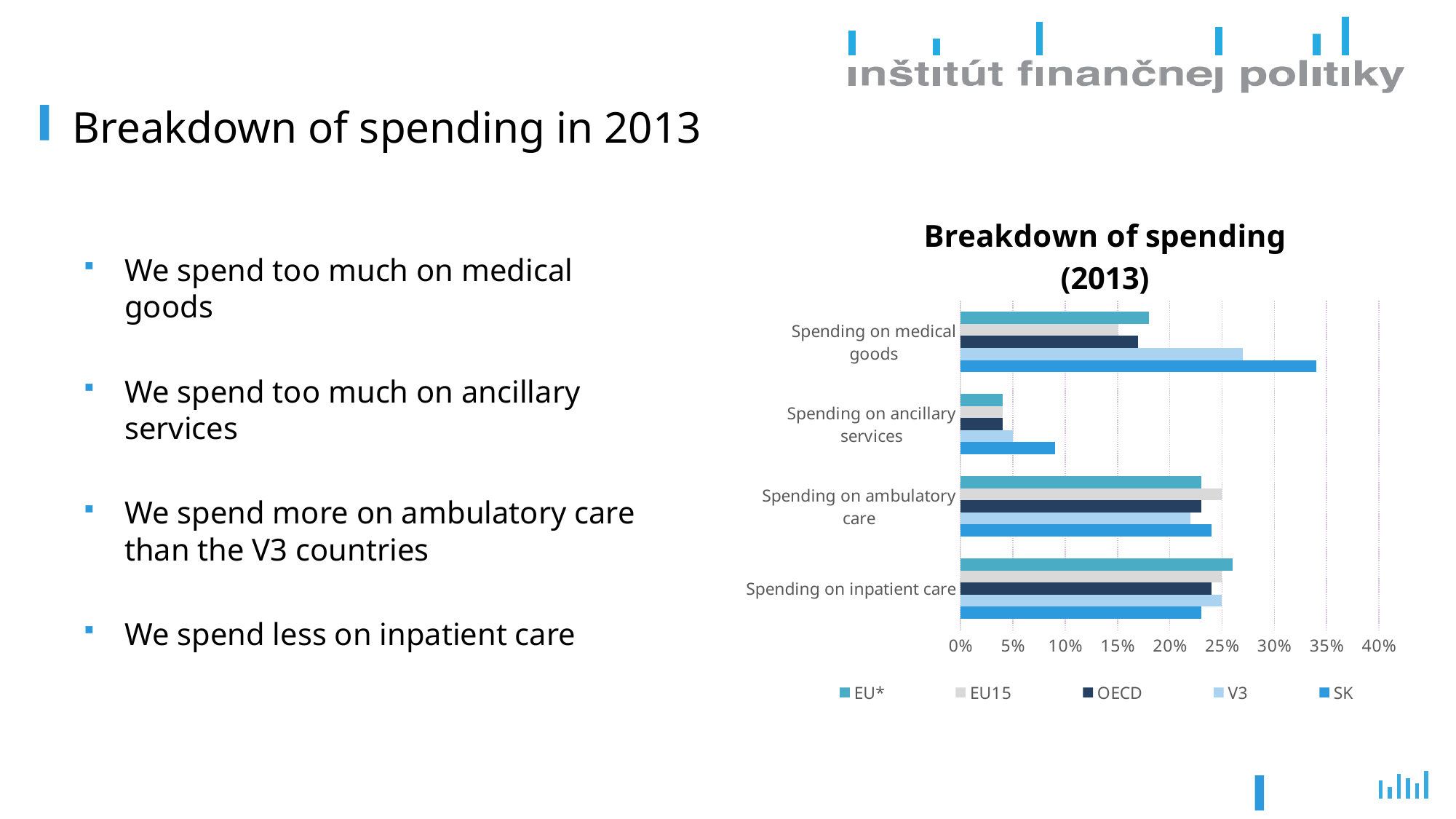
For Spending on medical goods, which is larger: the SK value or the OECD value? SK For Spending on ambulatory care, which is larger: the SK value or the V3 value? SK Which series has the highest value for Spending on medical goods? SK Is the SK value for Spending on medical goods greater or less than 30%? greater What kind of chart is shown on the slide? bar chart How many spending categories are shown on the chart? 4 Which series has the highest value for Spending on ancillary services? SK How many series does the chart legend list? 5 Is the V3 value for Spending on medical goods greater or less than 25%? greater Is the EU15 value for Spending on medical goods greater or less than 20%? less What is the title of the chart? Breakdown of spending (2013)